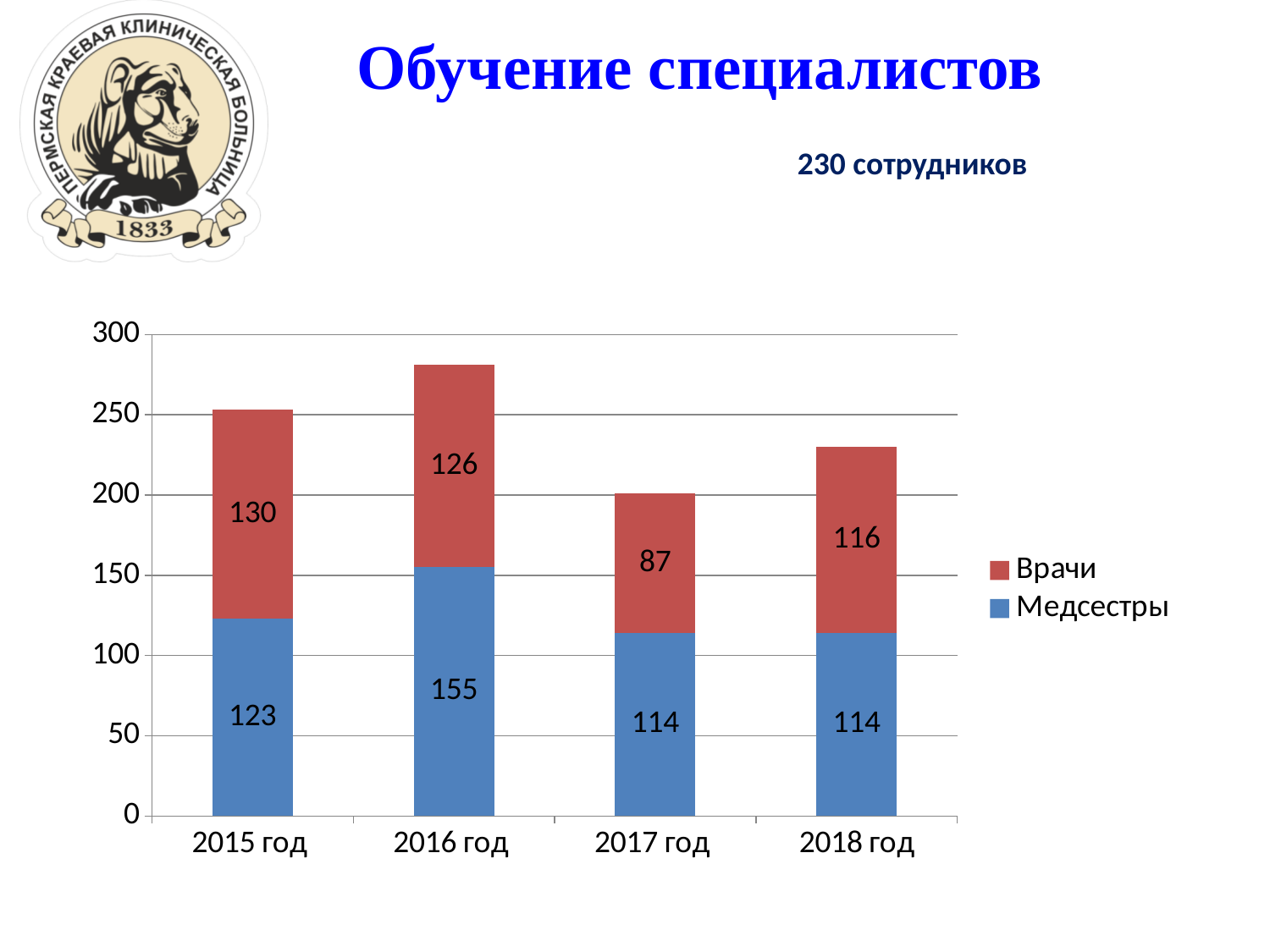
Which year has the lowest value for Врачи? 2017 год What is the value for Врачи in 2018 год? 116 What is the value for Медсестры in 2017 год? 114 What is the value for Врачи in 2016 год? 126 What kind of chart is shown on the slide? Stacked bar chart Which is larger: Медсестры in 2015 год or Медсестры in 2016 год? Медсестры in 2016 год Which year has the highest value for Медсестры? 2016 год How many series does the legend list? 2 What is the total of the stacked bar for 2016 год? 281 What is the total of the stacked bar for 2018 год? 230 What is the difference between the Врачи values for 2015 год and 2017 год? 43 How many years are shown on the x axis? 4